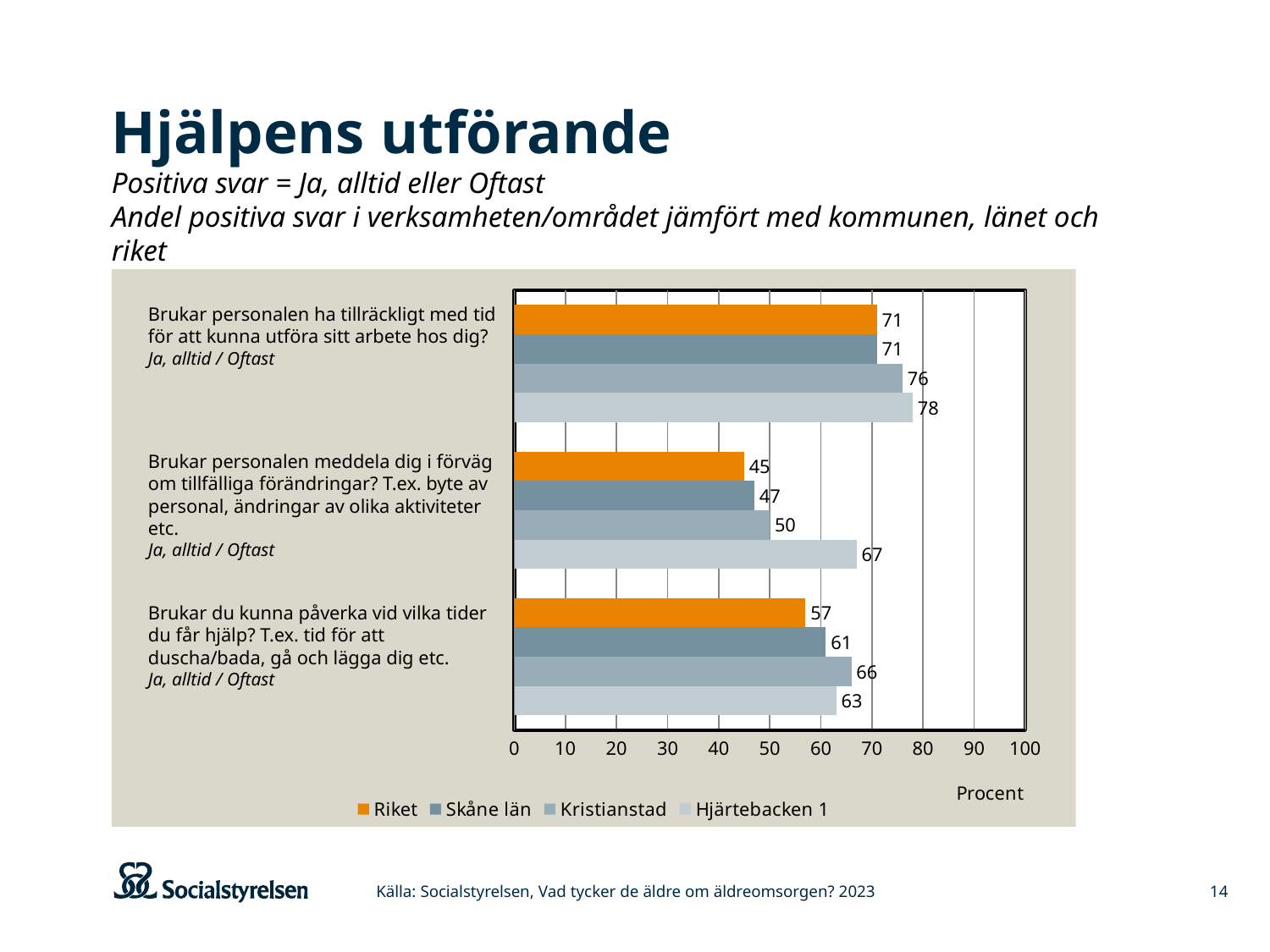
Which series has the lowest value on the question "Brukar du kunna påverka vid vilka tider du får hjälp?"? Riket On the question "Brukar du kunna påverka vid vilka tider du får hjälp?", which is larger: Kristianstad or Hjärtebacken 1? Kristianstad What is the value for Hjärtebacken 1 on the question "Brukar personalen ha tillräckligt med tid för att kunna utföra sitt arbete hos dig?"? 78 What is the difference between Hjärtebacken 1 and Riket on the question "Brukar personalen meddela dig i förväg om tillfälliga förändringar?"? 22 What kind of chart is shown on the slide? Bar chart How many questions (categories) are shown in the chart? 3 Which series has the highest value on the question "Brukar personalen meddela dig i förväg om tillfälliga förändringar?"? Hjärtebacken 1 What is the value for Riket on the question "Brukar personalen meddela dig i förväg om tillfälliga förändringar?"? 45 How many series does the legend list? 4 What is the value for Skåne län on the question "Brukar du kunna påverka vid vilka tider du får hjälp?"? 61 What is the value for Kristianstad on the question "Brukar du kunna påverka vid vilka tider du får hjälp?"? 66 What unit is shown on the horizontal axis of the chart? Procent